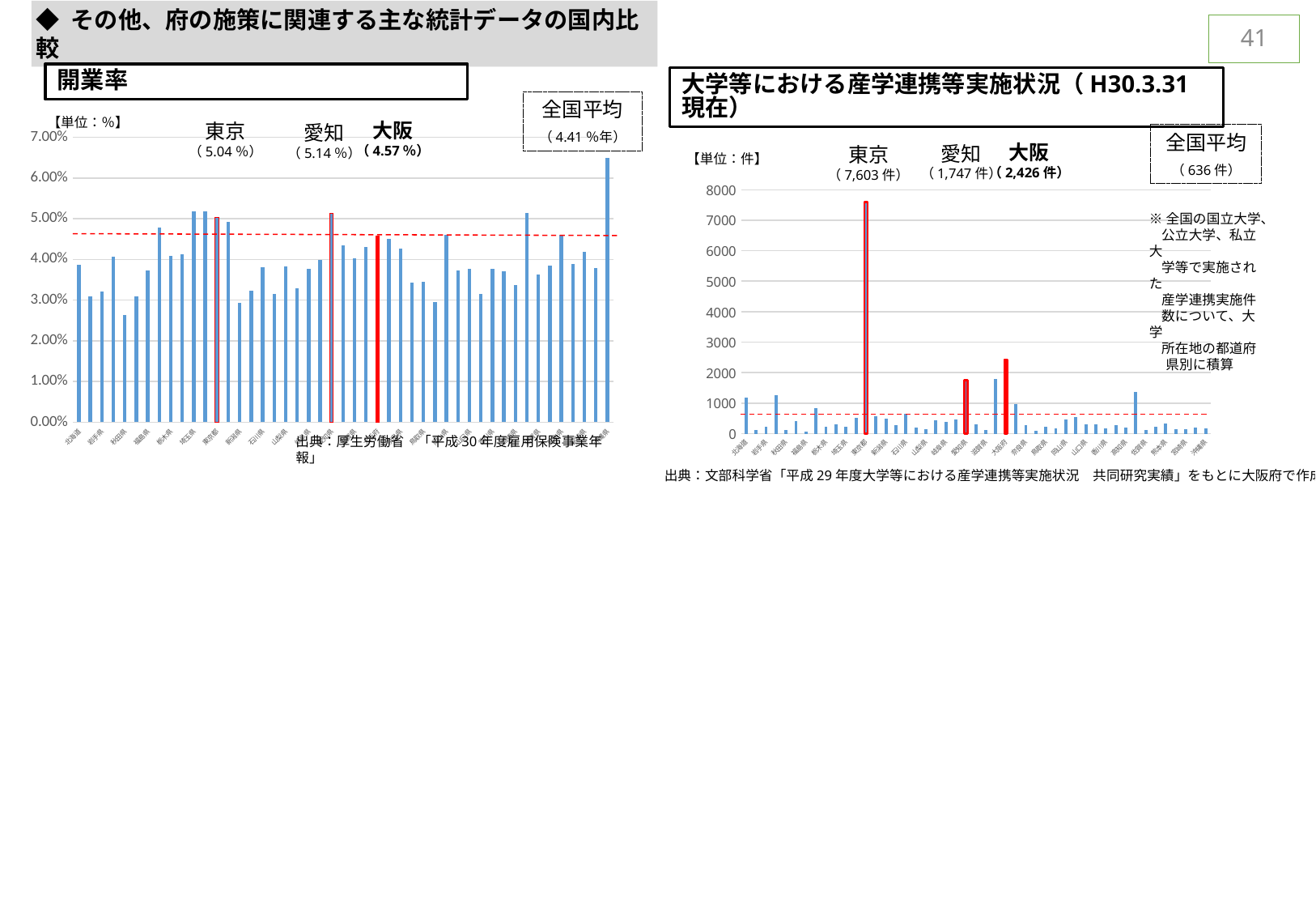
In the 開業率 chart on the left, what is the value shown for 愛知? 5.14% In the 大学等における産学連携等実施状況 chart on the right, what is the value shown for 大阪? 2,426件 In the 大学等における産学連携等実施状況 chart on the right, what is the value shown for 愛知? 1,747件 In the 大学等における産学連携等実施状況 chart on the right, what is the 全国平均 (national average) value? 636件 In the 大学等における産学連携等実施状況 chart on the right, what is the value shown for 東京? 7,603件 In the 開業率 chart on the left, what is the value shown for 大阪? 4.57% In the 開業率 chart on the left, which is larger, the value for 東京 or the value for 愛知? 愛知 What kind of chart is the 大学等における産学連携等実施状況 chart on the right? bar chart In the 大学等における産学連携等実施状況 chart on the right, which prefecture has the highest bar? 東京 In the 開業率 chart on the left, what is the 全国平均 (national average) value? 4.41% In the 開業率 chart on the left, what is the difference between the values for 愛知 and 大阪? 0.57% In the 開業率 chart on the left, what is the value shown for 東京? 5.04%